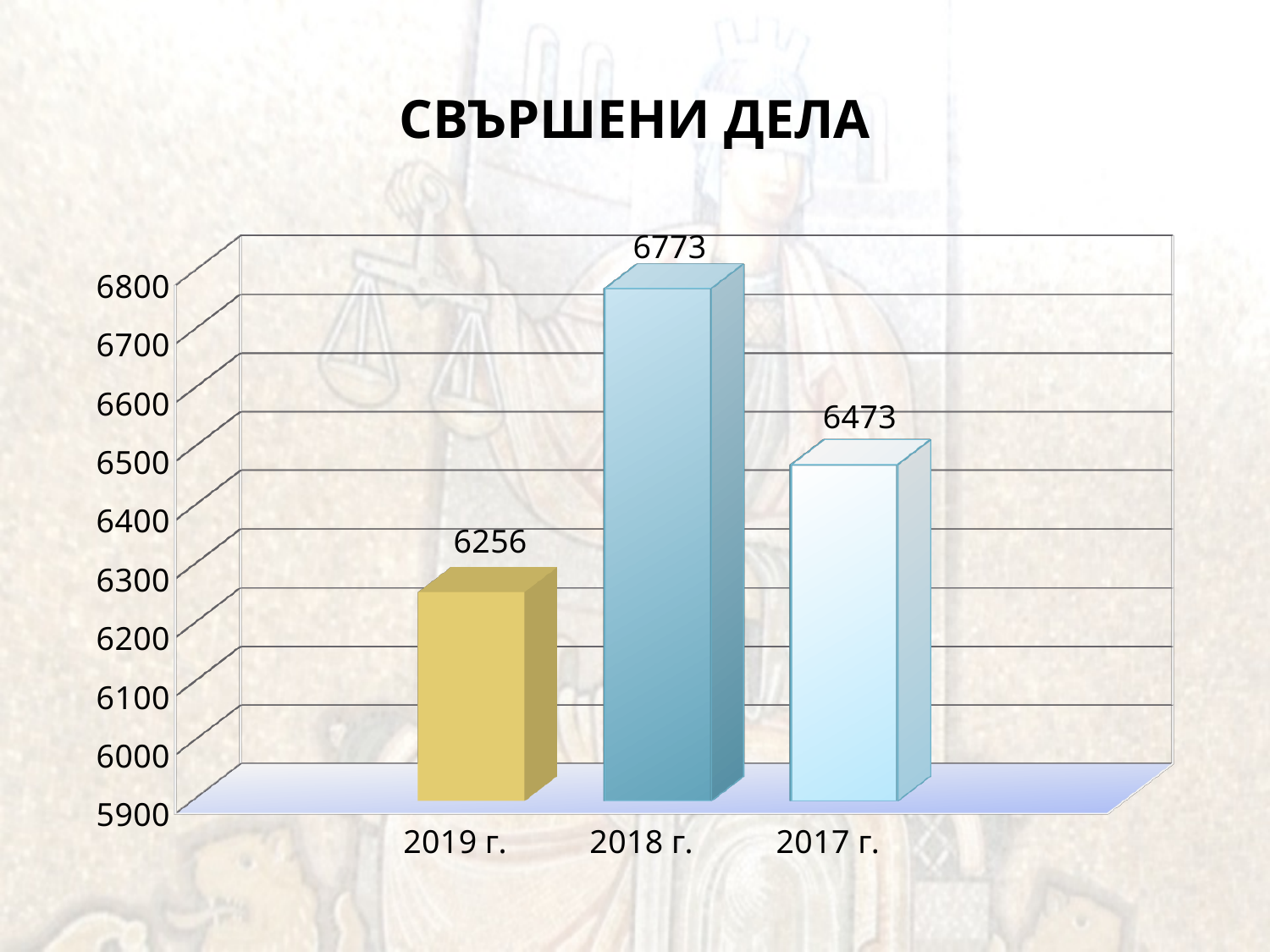
What is the value for 2019 г.? 6256 Which year has the lowest value? 2019 г. What is the difference between the values for 2017 г. and 2019 г.? 217 What is the title of the chart? СВЪРШЕНИ ДЕЛА How many categories are shown on the chart? 3 What is the difference between the values for 2018 г. and 2017 г.? 300 What kind of chart is shown on the slide? bar chart What is the value for 2017 г.? 6473 Is the value for 2019 г. greater or less than 6300? less Which is larger, the value for 2017 г. or the value for 2019 г.? 2017 г. What is the value for 2018 г.? 6773 Which year has the highest value? 2018 г.